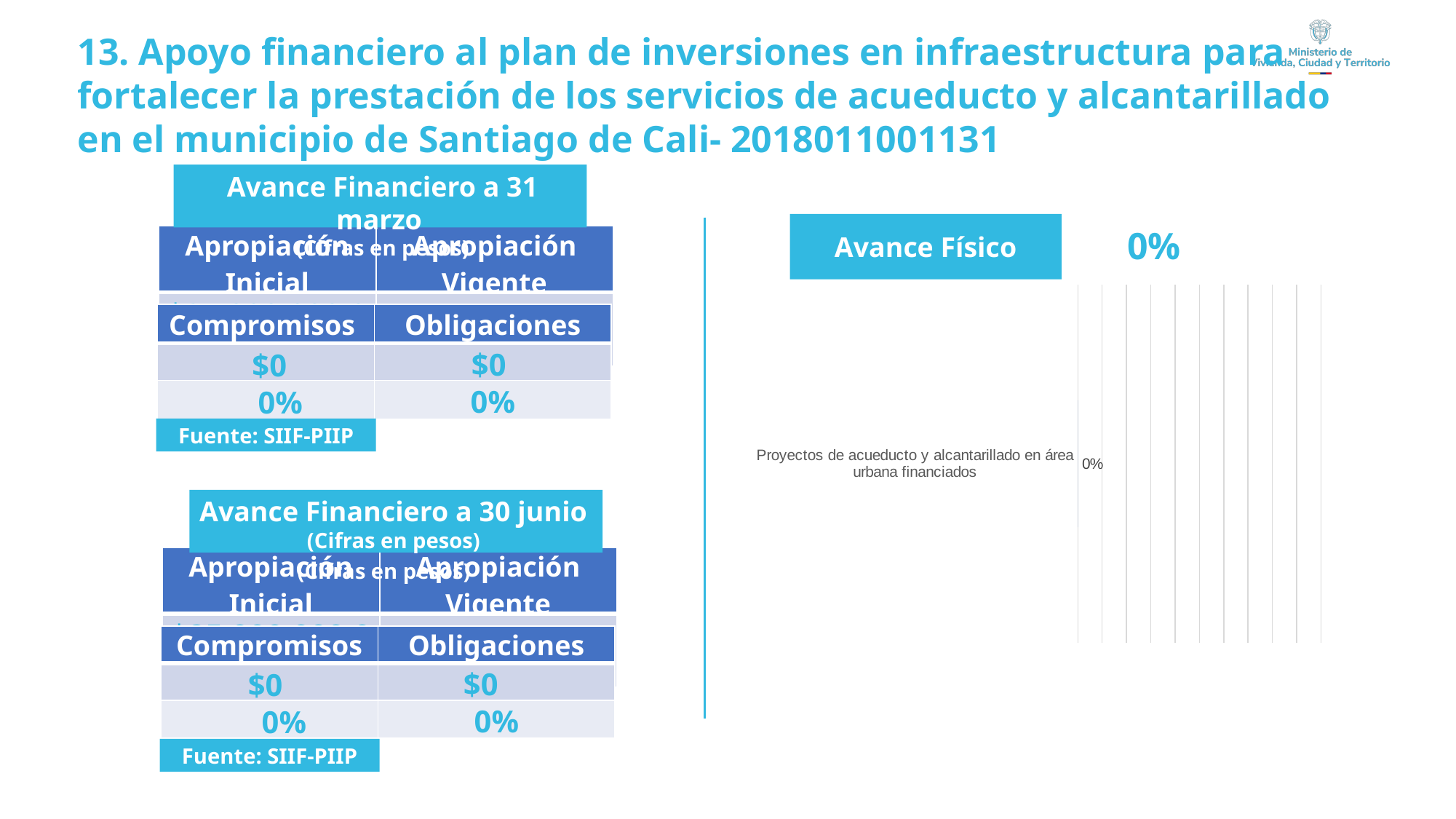
What overall percentage is displayed next to the 'Avance Físico' heading above the chart? 0% How many categories are plotted in the Avance Físico chart? 1 What is the label of the only category in the Avance Físico chart? Proyectos de acueducto y alcantarillado en área urbana financiados In the Avance Físico chart, what is the value shown for 'Proyectos de acueducto y alcantarillado en área urbana financiados'? 0%